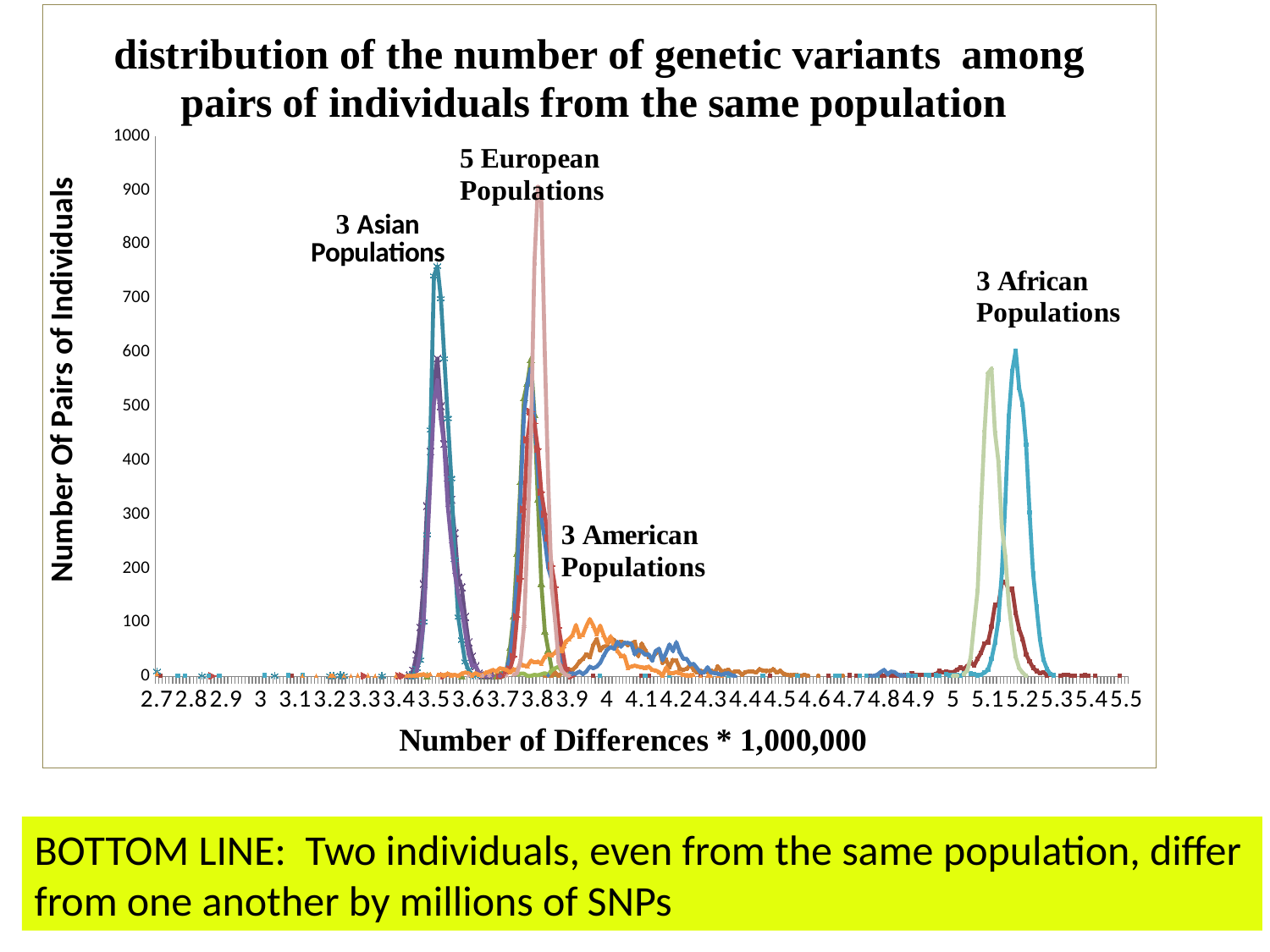
How many labelled population groups are annotated on the chart? 4 Is the highest peak of the 3 Asian Populations greater or less than 700? greater What kind of chart is shown on the slide? line chart Is the highest peak of the 3 American Populations greater or less than 200? less Is the highest peak of the 3 African Populations greater or less than 700? less What is the label of the x axis? Number of Differences * 1,000,000 Which has a higher peak, the 3 Asian Populations or the 3 African Populations? 3 Asian Populations What is the title of the chart? distribution of the number of genetic variants among pairs of individuals from the same population Which labelled population group has its peaks at the largest number of differences on the x axis? 3 African Populations Which labelled population group has the lowest peak on the chart? 3 American Populations Which labelled population group has the highest peak on the chart? 5 European Populations